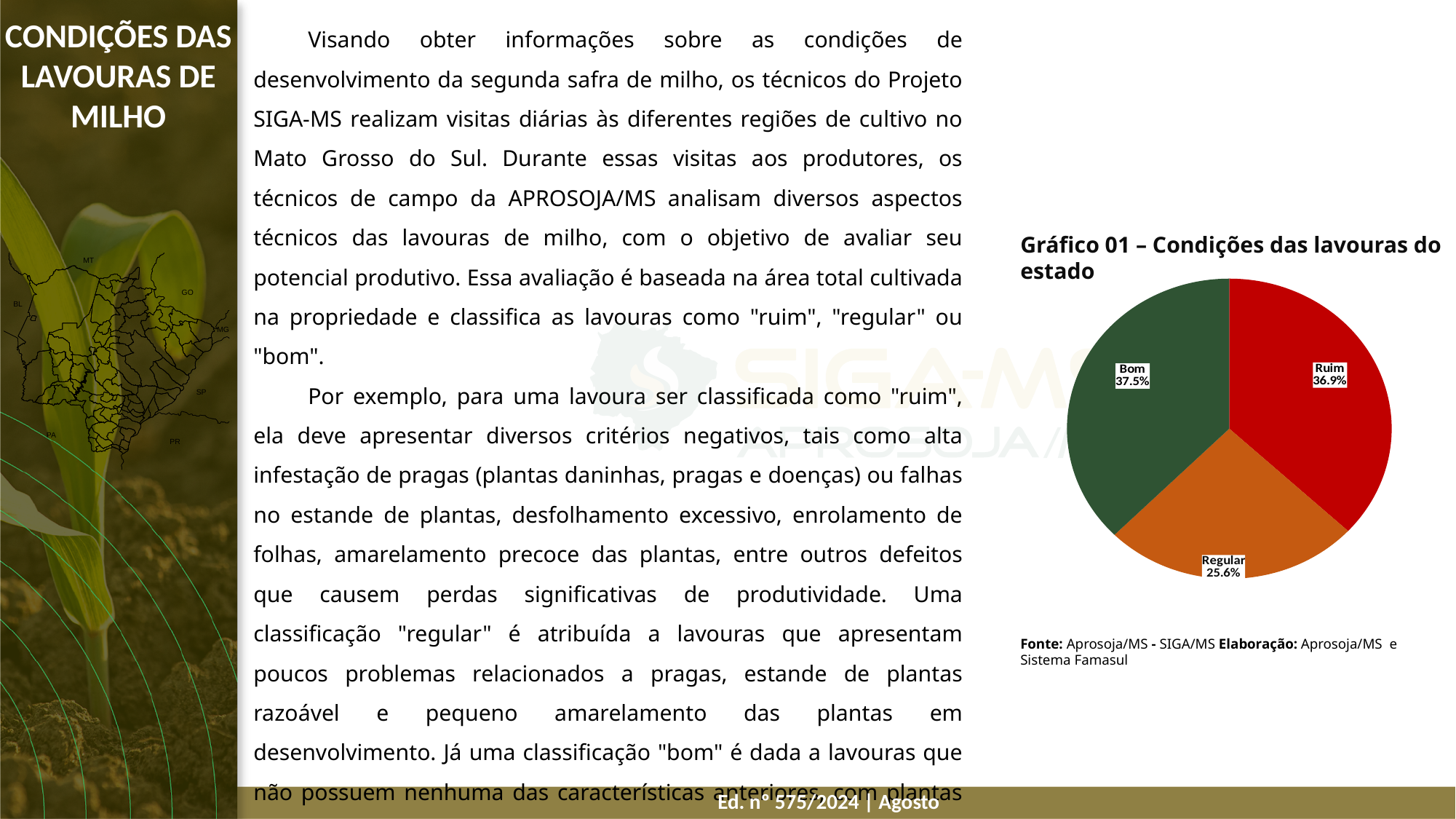
Which category has the largest share of the pie? Bom What is the title of the chart? Gráfico 01 – Condições das lavouras do estado Which is larger, the share for Bom or the share for Regular? Bom Which category has the smallest share of the pie? Regular What percentage of the lavouras is classified as Ruim? 36.9% What kind of chart is shown on the slide? pie chart What percentage of the lavouras is classified as Bom? 37.5% How many categories are shown in the pie chart? 3 What percentage of the lavouras is classified as Regular? 25.6% What colour is the Ruim slice of the pie? red What is the difference between the Bom share and the Regular share? 11.9% What is the difference between the Ruim share and the Regular share? 11.3%